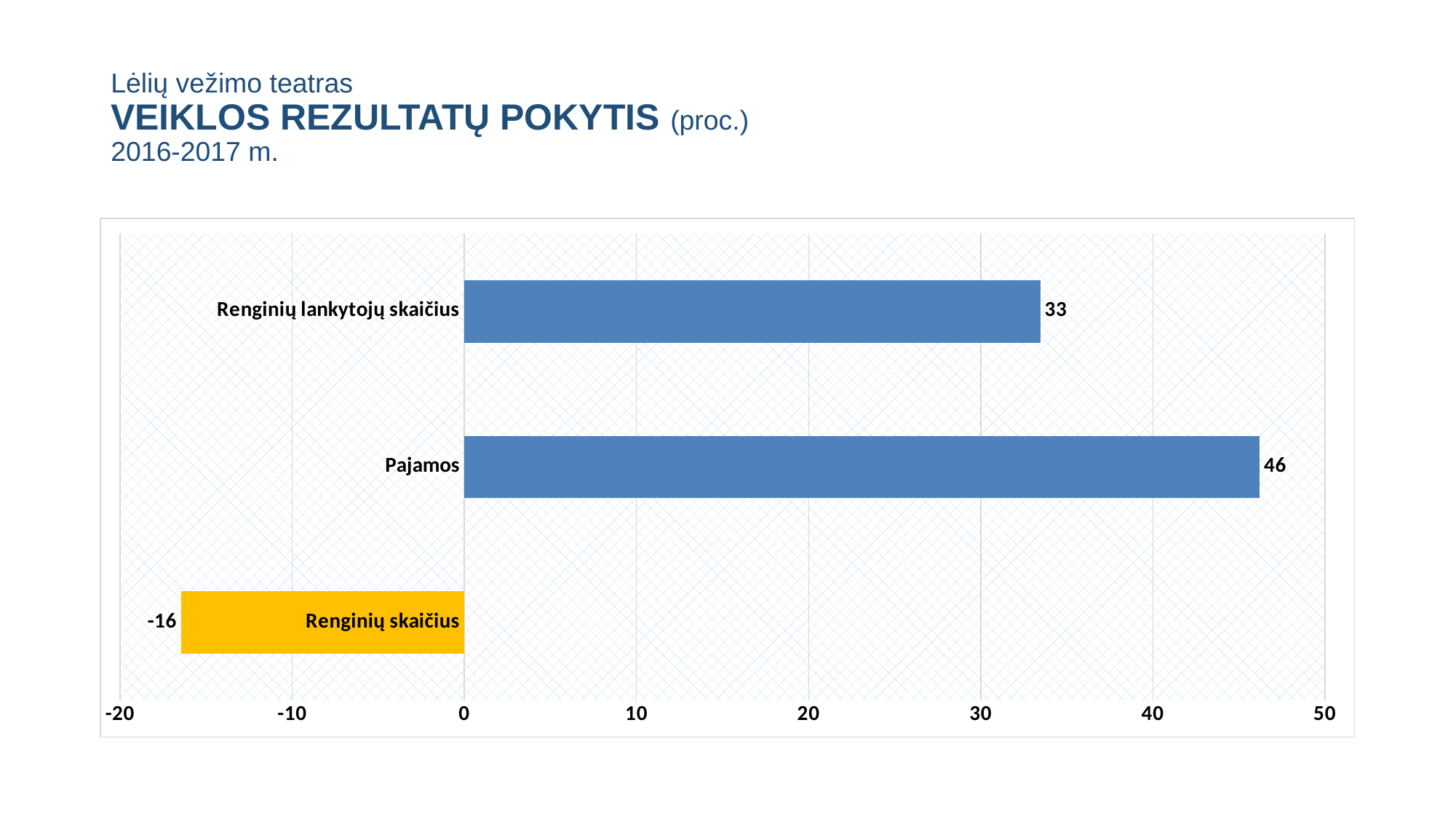
What is the value for Renginių lankytojų skaičius? 33 What period does the chart title refer to? 2016-2017 m. Which category has the lowest value? Renginių skaičius How many categories are shown in the chart? 3 Is the value for Pajamos greater or less than 40? greater Which category's bar is coloured yellow? Renginių skaičius What is the value for Renginių skaičius? -16 What kind of chart is shown on the slide? bar chart Which is larger, the value for Pajamos or the value for Renginių lankytojų skaičius? Pajamos What is the difference between the values for Pajamos and Renginių lankytojų skaičius? 13 What is the value for Pajamos? 46 Which category has the highest value? Pajamos